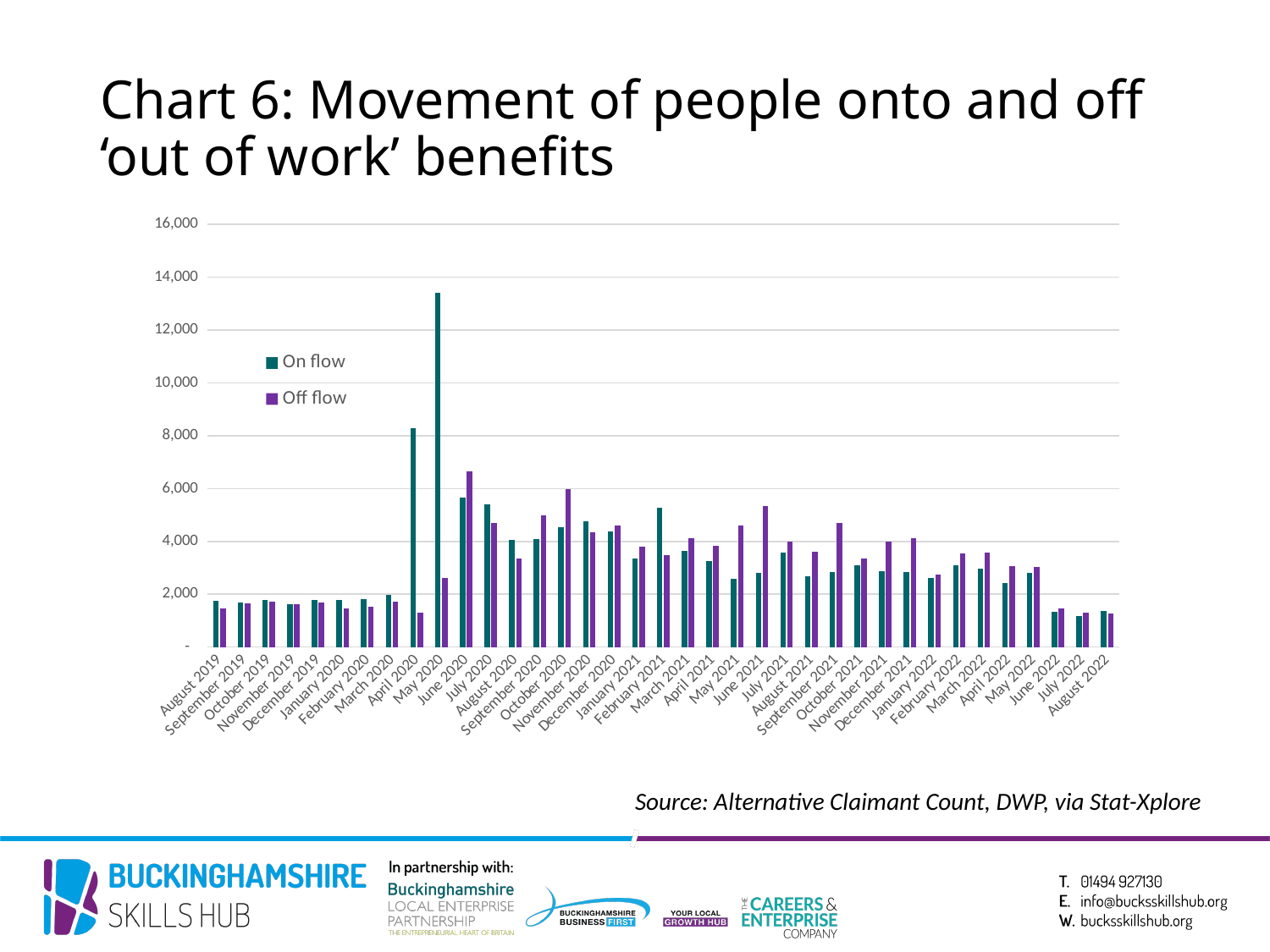
In July 2020, which is larger: On flow or Off flow? On flow In which month is the Off flow value highest? June 2020 Is the On flow value for August 2019 greater or less than 2,000? less What kind of chart is shown on the slide? bar chart What are the two series named in the legend? On flow and Off flow Is the On flow value for May 2020 greater or less than 12,000? greater Is the On flow value for April 2020 greater or less than 8,000? greater How many months are shown along the x axis? 37 In April 2020, which is larger: On flow or Off flow? On flow How many series does the legend list? 2 In which month is the On flow value highest? May 2020